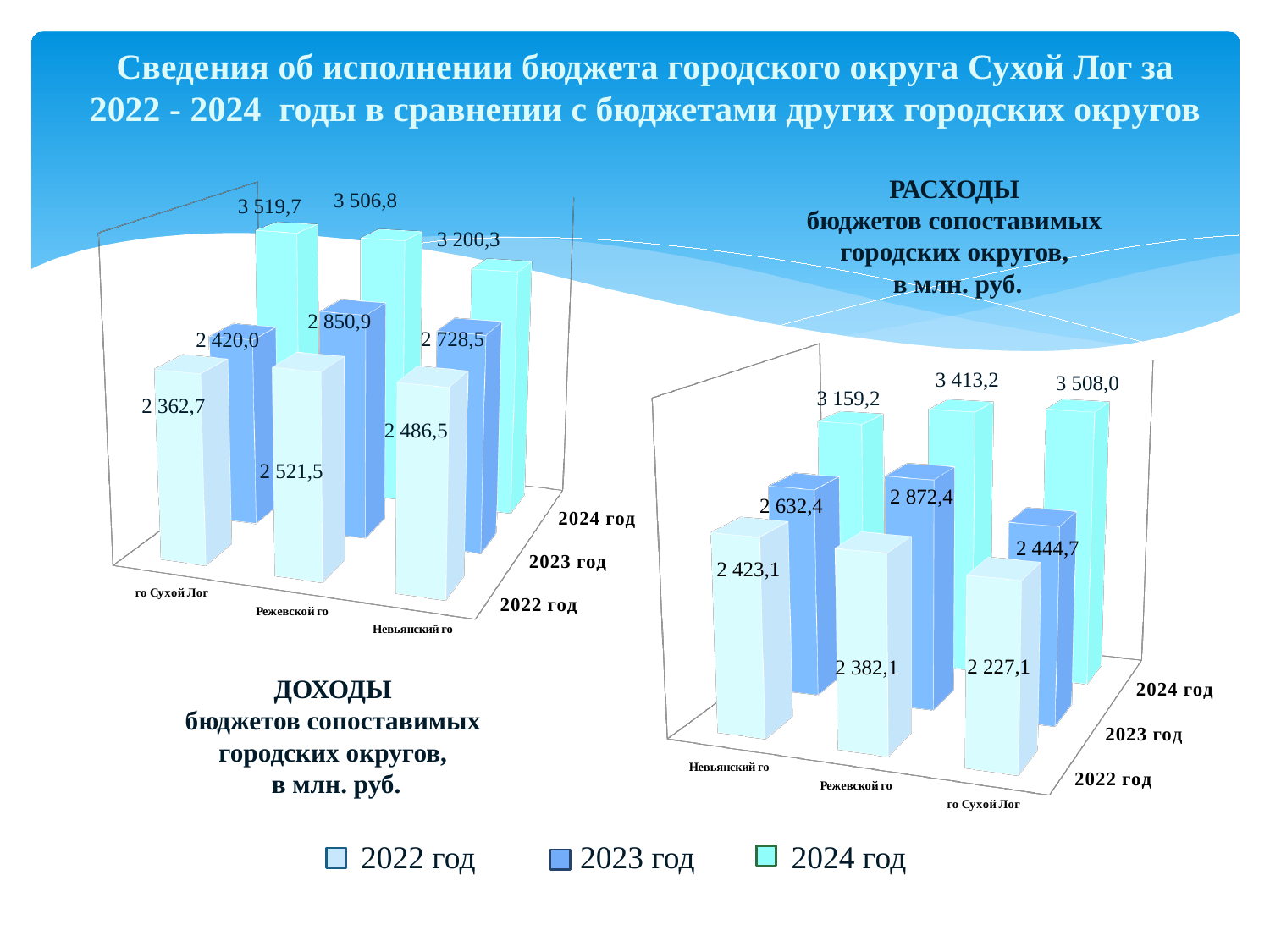
On the РАСХОДЫ chart (right), which is larger: the 2024 год value for Невьянский го or for Режевской го? Режевской го On the РАСХОДЫ chart (right), do the values for Невьянский го rise or fall from 2022 год to 2024 год? rise On the ДОХОДЫ chart (left), what is the value for го Сухой Лог in 2022 год? 2 362,7 On the ДОХОДЫ chart (left), what is the value for Невьянский го in 2023 год? 2 728,5 On the РАСХОДЫ chart (right), what is the value for го Сухой Лог in 2024 год? 3 508,0 On the РАСХОДЫ chart (right), which city district has the lowest value in 2022 год? го Сухой Лог What kind of chart is the ДОХОДЫ chart (left)? bar chart How many series does the legend list? 3 On the ДОХОДЫ chart (left), what is the difference between the 2024 год and 2022 год values for го Сухой Лог? 1 157,0 On the ДОХОДЫ chart (left), which city district has the highest value in 2024 год? го Сухой Лог On the ДОХОДЫ chart (left), what is the value for Режевской го in 2024 год? 3 506,8 On the РАСХОДЫ chart (right), what is the value for Режевской го in 2023 год? 2 872,4